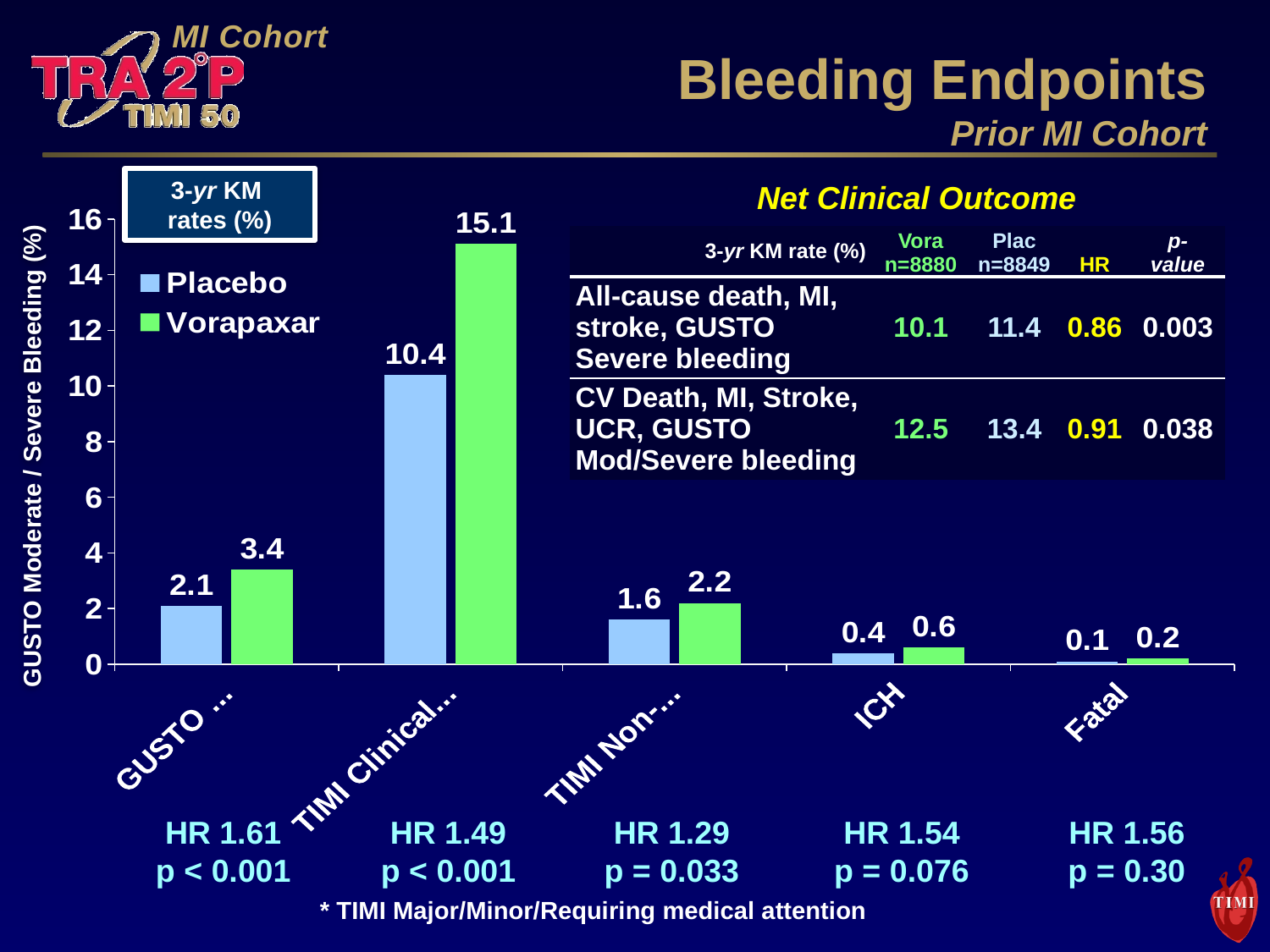
What is the Placebo value for ICH? 0.4 Which category has the lowest Placebo value? Fatal How many categories are shown on the x axis of the bar chart? 5 What is the highest value shown for Placebo on the chart? 10.4 What is the Vorapaxar value for ICH? 0.6 What is the highest value shown for Vorapaxar on the chart? 15.1 What is the difference between the Vorapaxar and Placebo values for ICH? 0.2 Which is larger for Fatal, the Placebo value or the Vorapaxar value? Vorapaxar What type of chart is shown on the slide? Bar chart What is the Vorapaxar value for Fatal? 0.2 What is the Placebo value for Fatal? 0.1 How many series does the chart legend list? 2